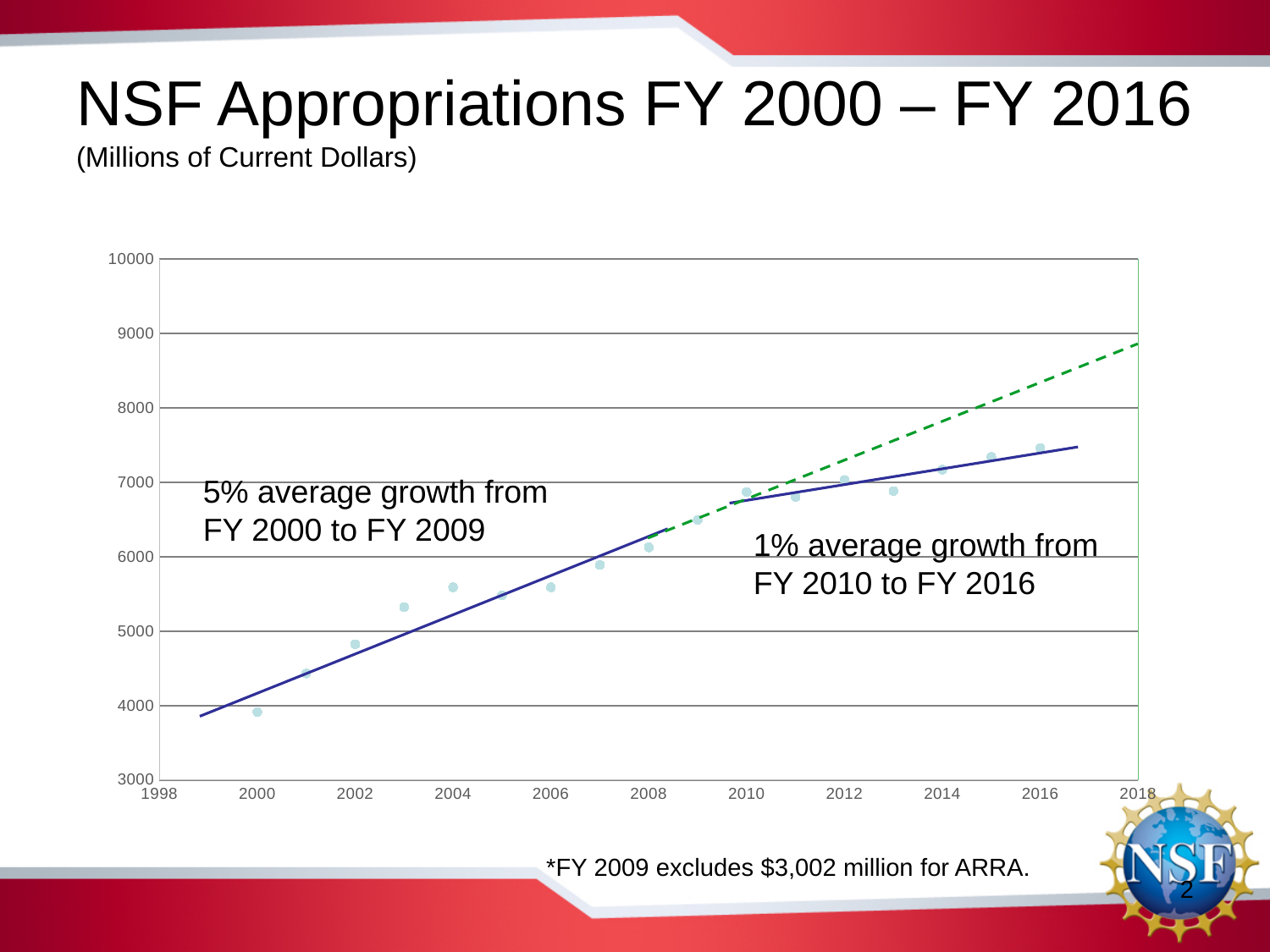
Is the value for 2010 greater or less than 7000? less What kind of chart is shown on the slide? scatter chart In what units are the values on the chart expressed? Millions of Current Dollars Which year has the lowest plotted value? 2000 Is the value for 2006 greater or less than 6000? less Is the value for 2016 greater or less than 7000? greater Which year has the highest plotted value? 2016 Do the plotted values generally rise or fall from 2000 to 2016? rise What is the title of the chart? NSF Appropriations FY 2000 – FY 2016 Which is larger, the value for 2003 or the value for 2004? 2004